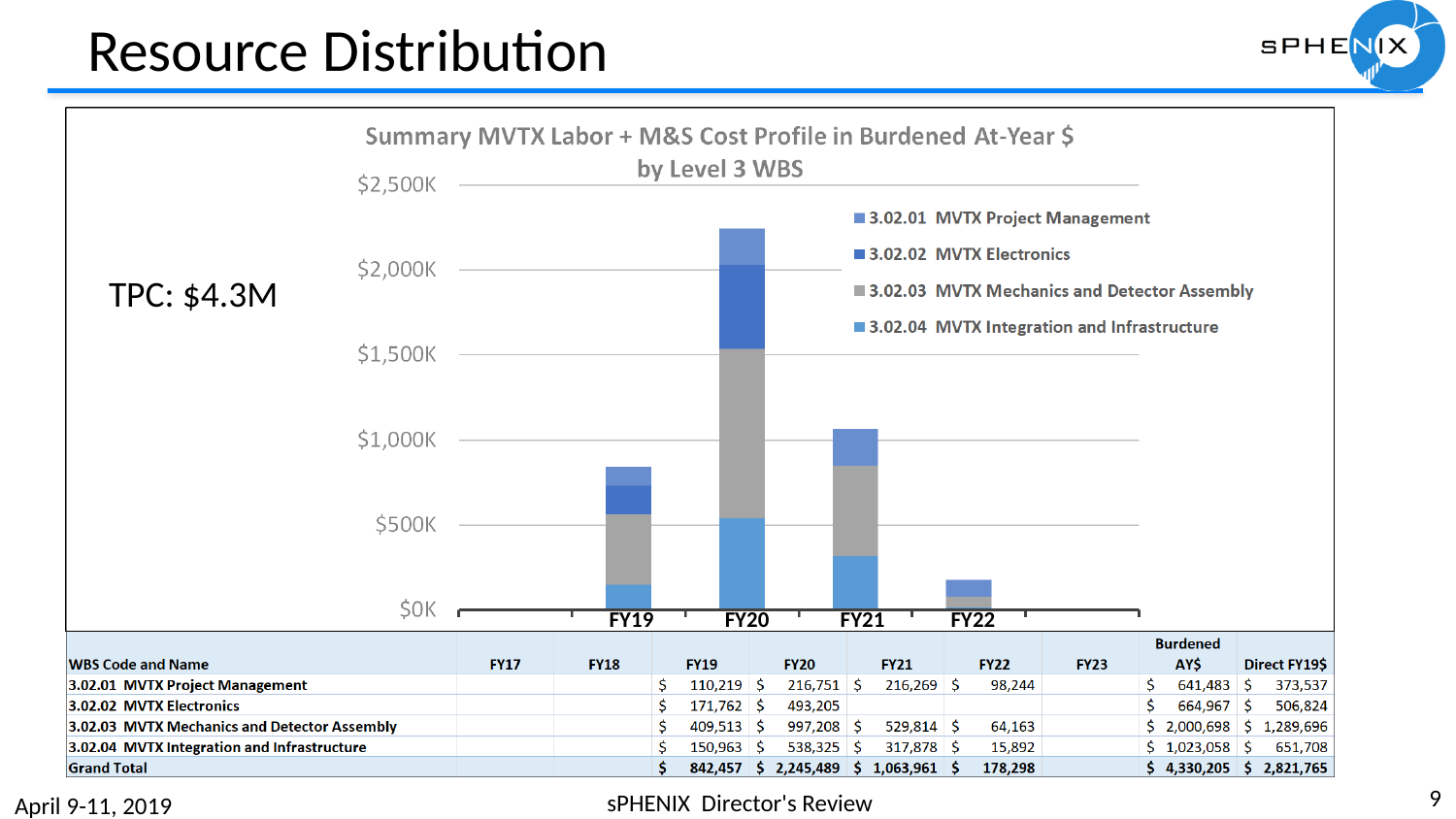
Which fiscal year has the shortest stacked bar? FY22 What kind of chart is shown on the slide? Stacked bar chart Which series in the legend is shown in gray? 3.02.03 MVTX Mechanics and Detector Assembly Is the total stacked bar for FY20 greater or less than $2,000K? greater Using the Grand Total row of the table, what is the difference between the FY20 and FY21 totals? 1,181,528 Which stacked bar is taller, FY19 or FY21? FY21 How many fiscal years are labeled on the chart's x axis? 4 According to the table below the chart, what is the FY19 value for 3.02.01 MVTX Project Management? $ 110,219 Which fiscal year has the tallest stacked bar? FY20 Is the total stacked bar for FY19 greater or less than $1,000K? less How many series does the chart legend list? 4 According to the table below the chart, what is the Grand Total for FY20? $ 2,245,489